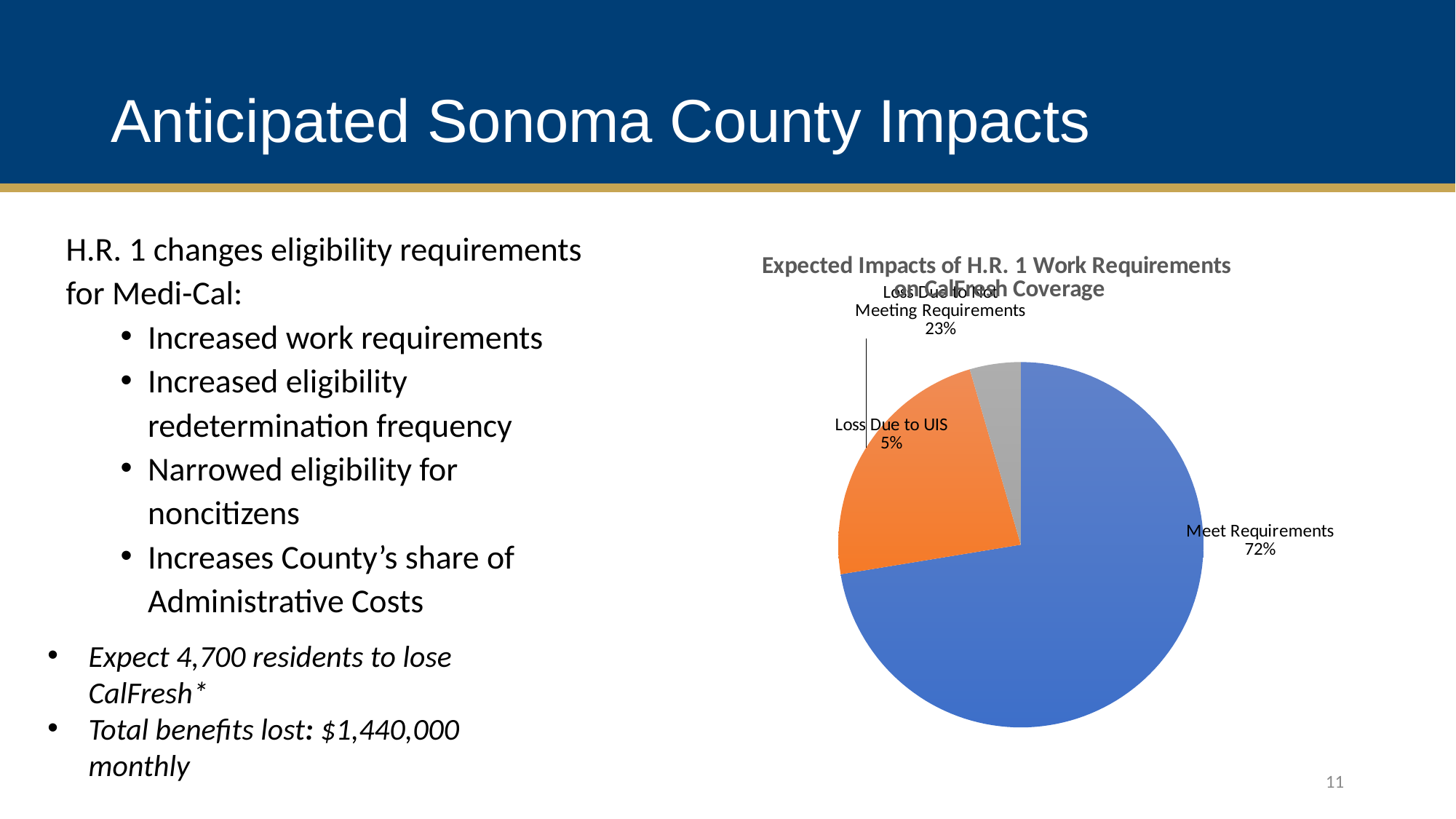
What is the difference in percentage points between the "Meet Requirements" slice and the "Loss Due to Not Meeting Requirements" slice? 49 Which slice of the pie chart is the largest? Meet Requirements What is the combined share of the two "Loss" slices in the pie chart? 28% What type of chart is shown on the slide? Pie chart What percentage of the pie is labelled "Meet Requirements"? 72% What percentage of the pie is labelled "Loss Due to UIS"? 5% Which is larger: the "Loss Due to Not Meeting Requirements" slice or the "Loss Due to UIS" slice? Loss Due to Not Meeting Requirements What is the title of the chart on the slide? Expected Impacts of H.R. 1 Work Requirements on CalFresh Coverage What percentage of the pie is labelled "Loss Due to Not Meeting Requirements"? 23% How many slices does the pie chart have? 3 What colour is the "Meet Requirements" slice of the pie chart? Blue Which slice of the pie chart is the smallest? Loss Due to UIS